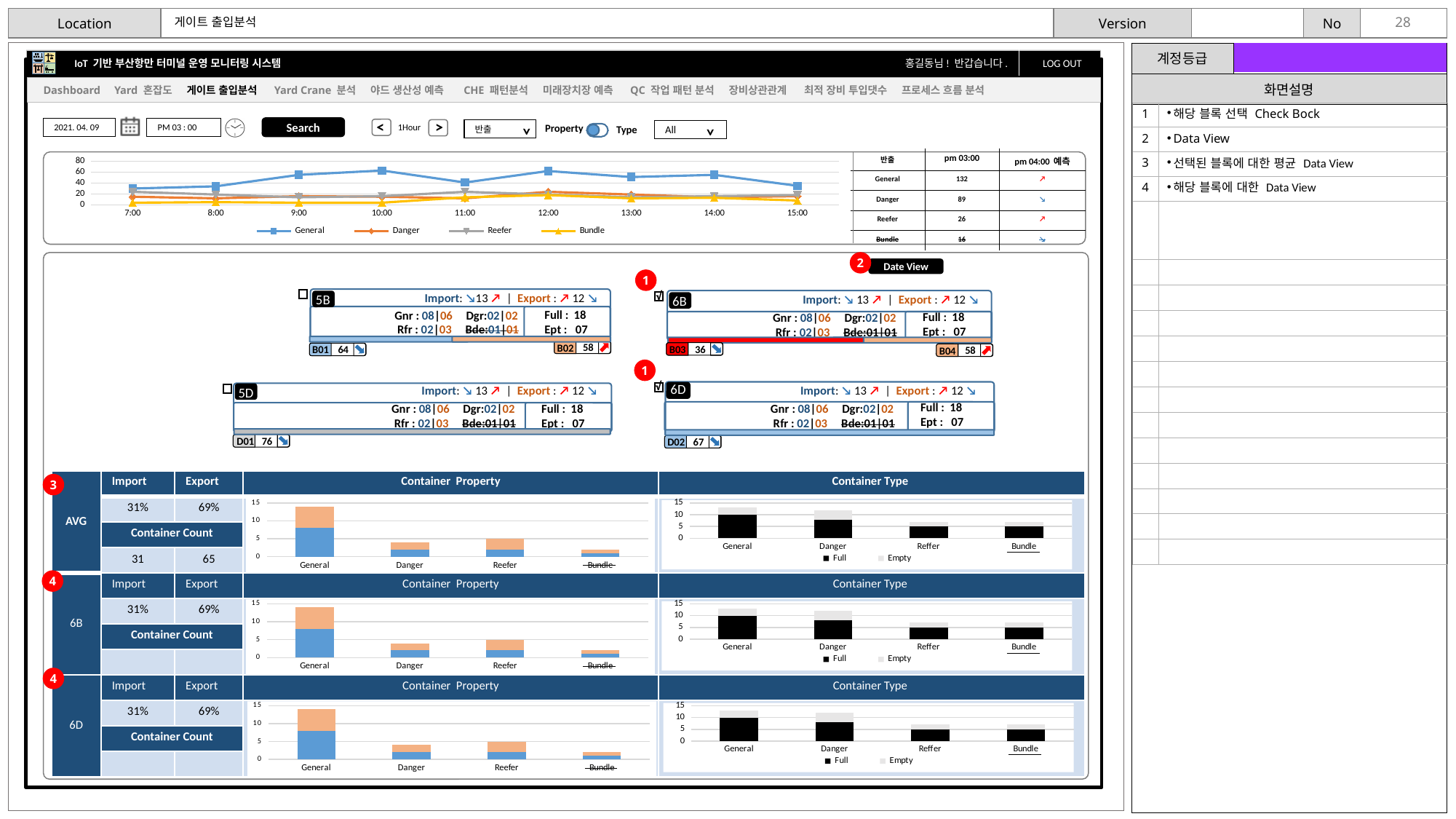
How many series does the legend of the top line chart list? 4 In the AVG row's Container Property chart, is the total bar for General greater or less than 10? greater In the top line chart, is the value for Bundle at 7:00 greater or less than 20? less In the top line chart, which series has the highest values across the time points? General In the AVG row's Container Property chart, which category has the shortest bar? Bundle What kind of chart is the top chart showing General, Danger, Reefer and Bundle over time? line chart In the AVG row's Container Type chart, which is larger, the bar for General or the bar for Reefer? General How many time points are plotted along the x axis of the top line chart? 9 In the AVG row's Container Type chart, how many series does the legend list? 2 In the top line chart, does the General series rise or fall from 7:00 to 10:00? rise In the top line chart, is the value for General at 10:00 greater or less than 40? greater In the AVG row's Container Property chart, which category has the tallest bar? General